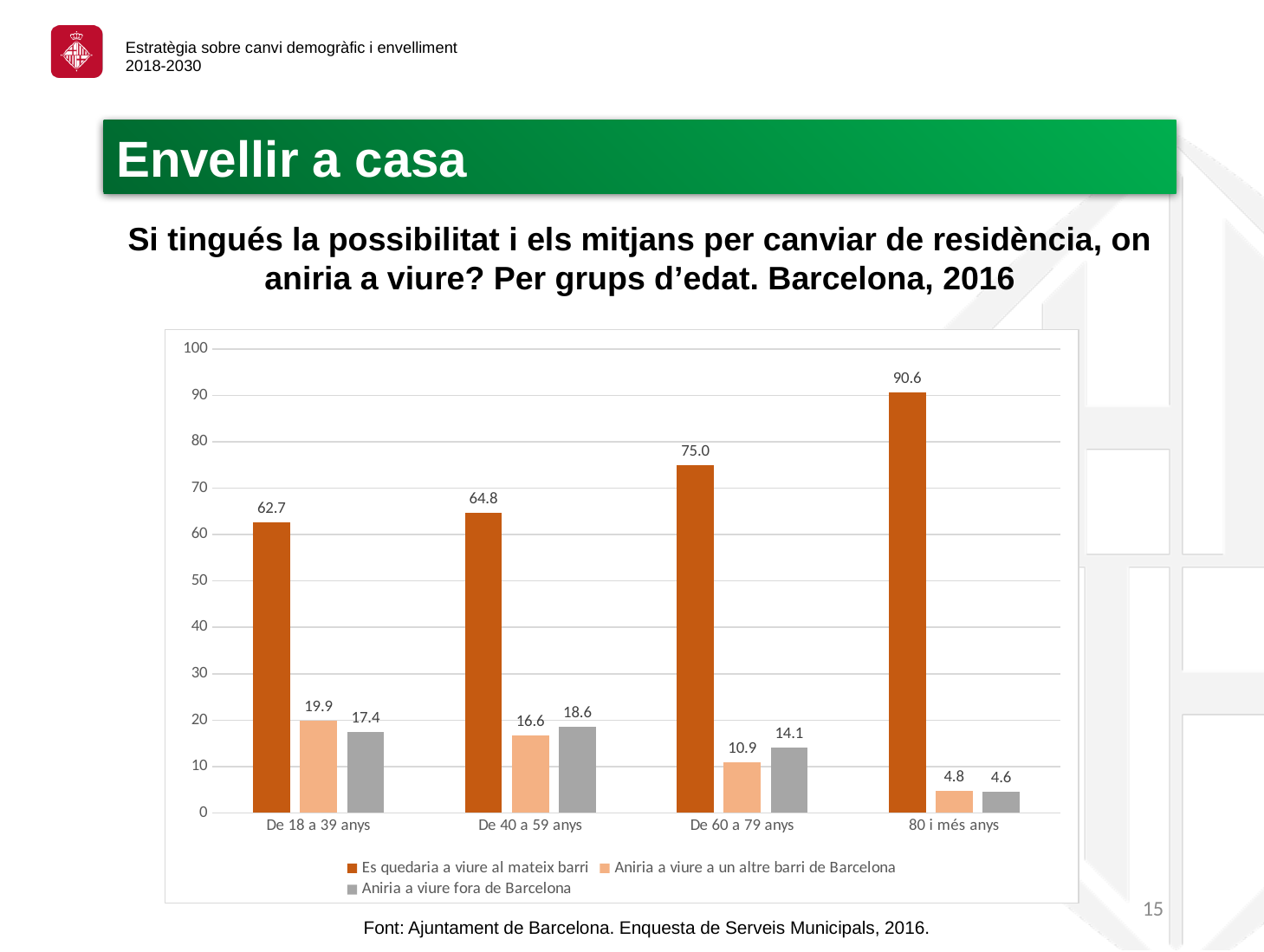
How many series does the legend list? 3 What is the value for "Aniria a viure fora de Barcelona" in the "De 60 a 79 anys" group? 14.1 How many age groups are shown on the x axis? 4 Is the value for "Es quedaria a viure al mateix barri" in the "De 60 a 79 anys" group greater or less than 70? greater Which age group has the lowest value for "Aniria a viure a un altre barri de Barcelona"? 80 i més anys Do the values for "Es quedaria a viure al mateix barri" rise or fall across the age groups from left to right? Rise In the "De 40 a 59 anys" group, which is larger: "Aniria a viure a un altre barri de Barcelona" or "Aniria a viure fora de Barcelona"? Aniria a viure fora de Barcelona What is the difference between the "Es quedaria a viure al mateix barri" values for "80 i més anys" and "De 18 a 39 anys"? 27.9 Which age group has the highest value for "Es quedaria a viure al mateix barri"? 80 i més anys What kind of chart is shown on the slide? Bar chart What is the value for "Aniria a viure a un altre barri de Barcelona" in the "De 18 a 39 anys" group? 19.9 What is the value for "Es quedaria a viure al mateix barri" in the "80 i més anys" group? 90.6